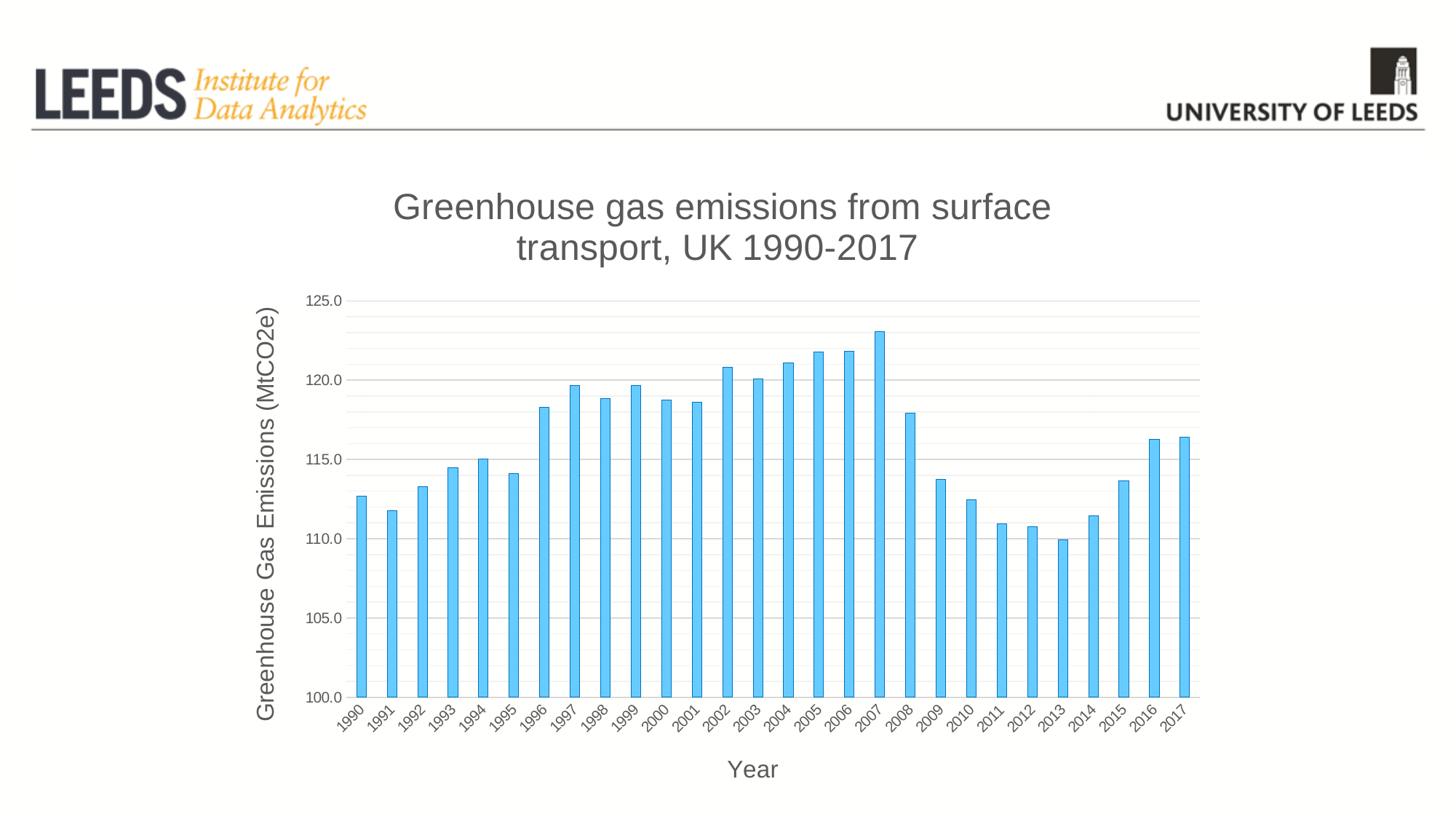
Which year has higher emissions, 1996 or 1995? 1996 Is the value for 1990 greater or less than 115.0? less Which year has the lowest greenhouse gas emissions from surface transport? 2013 Which year has the highest greenhouse gas emissions from surface transport? 2007 Is the value for 2007 greater or less than 120.0? greater How many years are plotted on the chart? 28 What kind of chart is shown on the slide? Bar chart Do emissions generally rise or fall from 2007 to 2013? Fall Which year has higher emissions, 2016 or 2010? 2016 What is the label on the vertical axis of the chart? Greenhouse Gas Emissions (MtCO2e) Is the value for 2002 greater or less than 120.0? greater